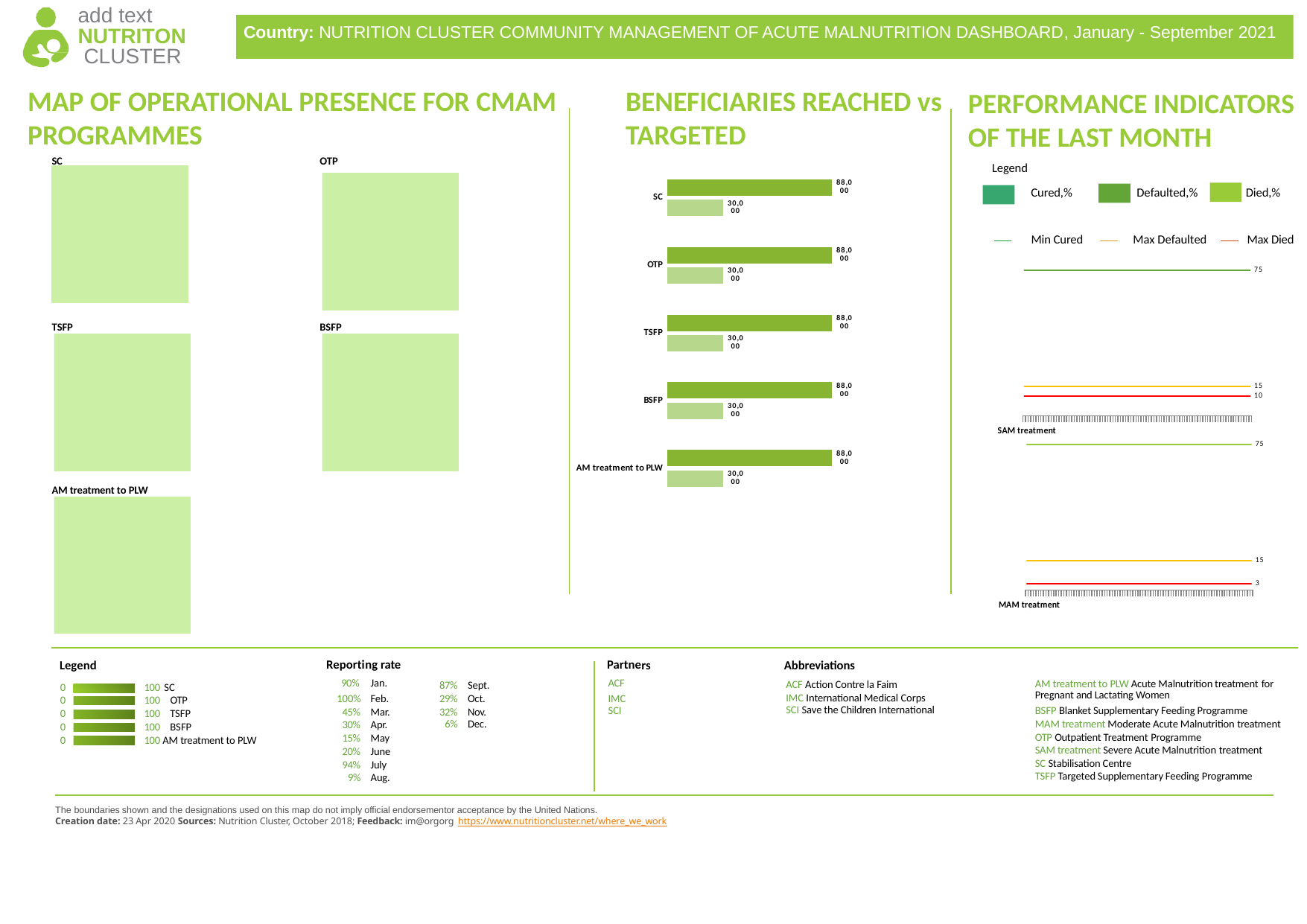
In the BENEFICIARIES REACHED vs TARGETED chart, what is the difference between the darker green bar and the lighter green bar for TSFP? 58,000 In the PERFORMANCE INDICATORS OF THE LAST MONTH chart, what value is marked by the Min Cured line for SAM treatment? 75 In the BENEFICIARIES REACHED vs TARGETED chart, which category is listed last (at the bottom)? AM treatment to PLW In the BENEFICIARIES REACHED vs TARGETED chart, which bar for BSFP is larger, the darker green bar or the lighter green bar? the darker green bar In the PERFORMANCE INDICATORS OF THE LAST MONTH chart, what value is marked by the Max Died line for MAM treatment? 3 In the PERFORMANCE INDICATORS OF THE LAST MONTH chart, what value is marked by the Max Defaulted line for SAM treatment? 15 In the PERFORMANCE INDICATORS OF THE LAST MONTH chart, how many coloured series does the legend list? 3 In the BENEFICIARIES REACHED vs TARGETED chart, how many categories are shown? 5 In the BENEFICIARIES REACHED vs TARGETED chart, what kind of chart is used? bar chart In the BENEFICIARIES REACHED vs TARGETED chart, what is the value of the lighter green (lower) bar for OTP? 30,000 In the PERFORMANCE INDICATORS OF THE LAST MONTH chart, how many treatment categories are shown? 2 In the BENEFICIARIES REACHED vs TARGETED chart, what is the value of the darker green (upper) bar for SC? 88,000